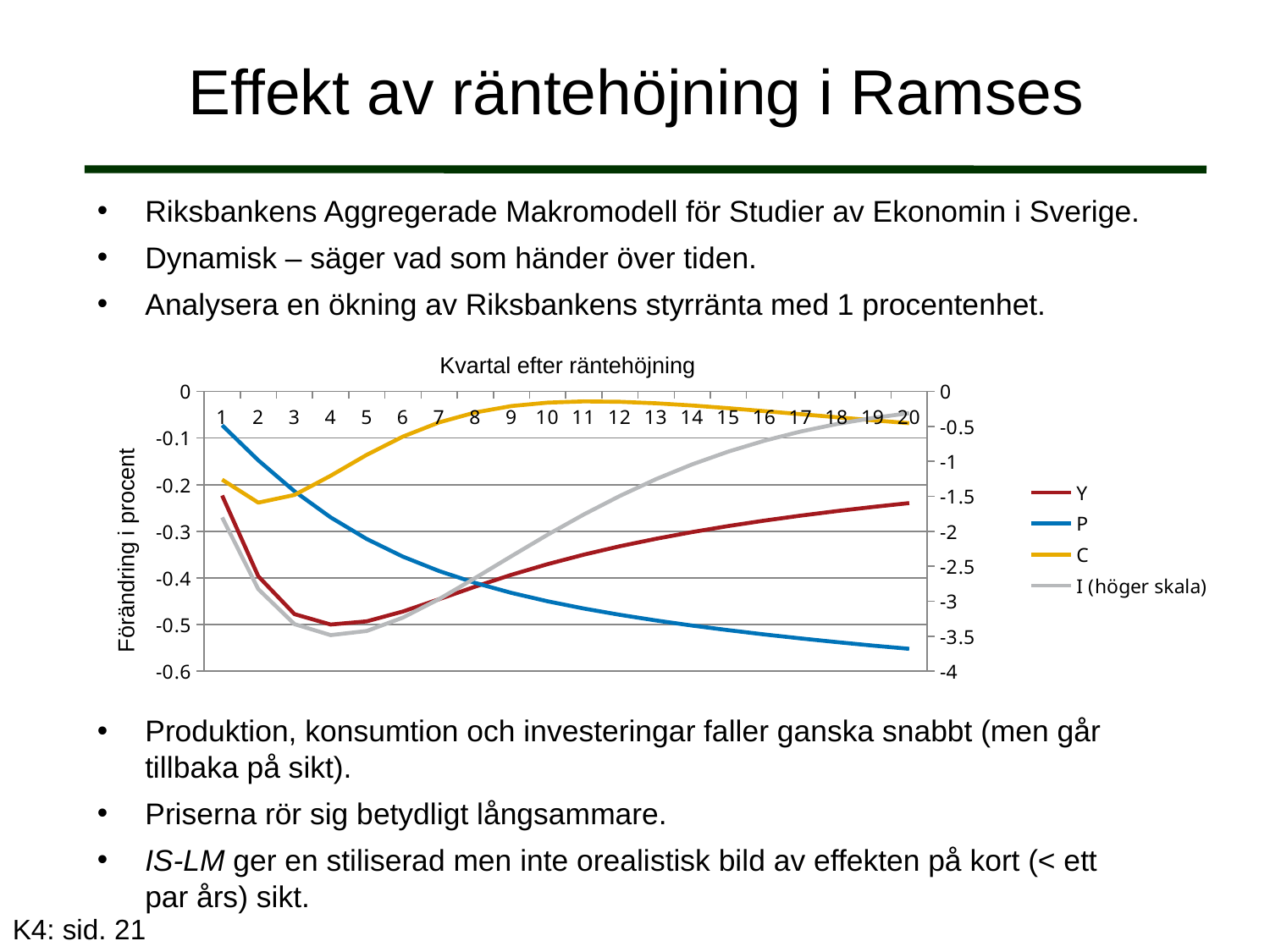
Is the value of Y at quarter 4 greater or less than -0.4? less What are the entries in the chart's legend? Y, P, C, I (höger skala) Is the value of P at quarter 20 greater or less than -0.5? less How many series does the chart's legend list? 4 Does the Y series rise or fall from quarter 4 to quarter 20? rises Is the value of C at quarter 10 greater or less than -0.1? greater Which series in the chart is plotted against the right-hand scale? I (höger skala) Does the P series rise or fall from quarter 1 to quarter 20? falls At quarter 1, which of the left-scale series (Y, P, C) has the lowest value? Y At quarter 20, which series has the higher value on the left scale, Y or P? Y What kind of chart is shown on the slide? line chart How many quarters are plotted along the x axis of the chart? 20